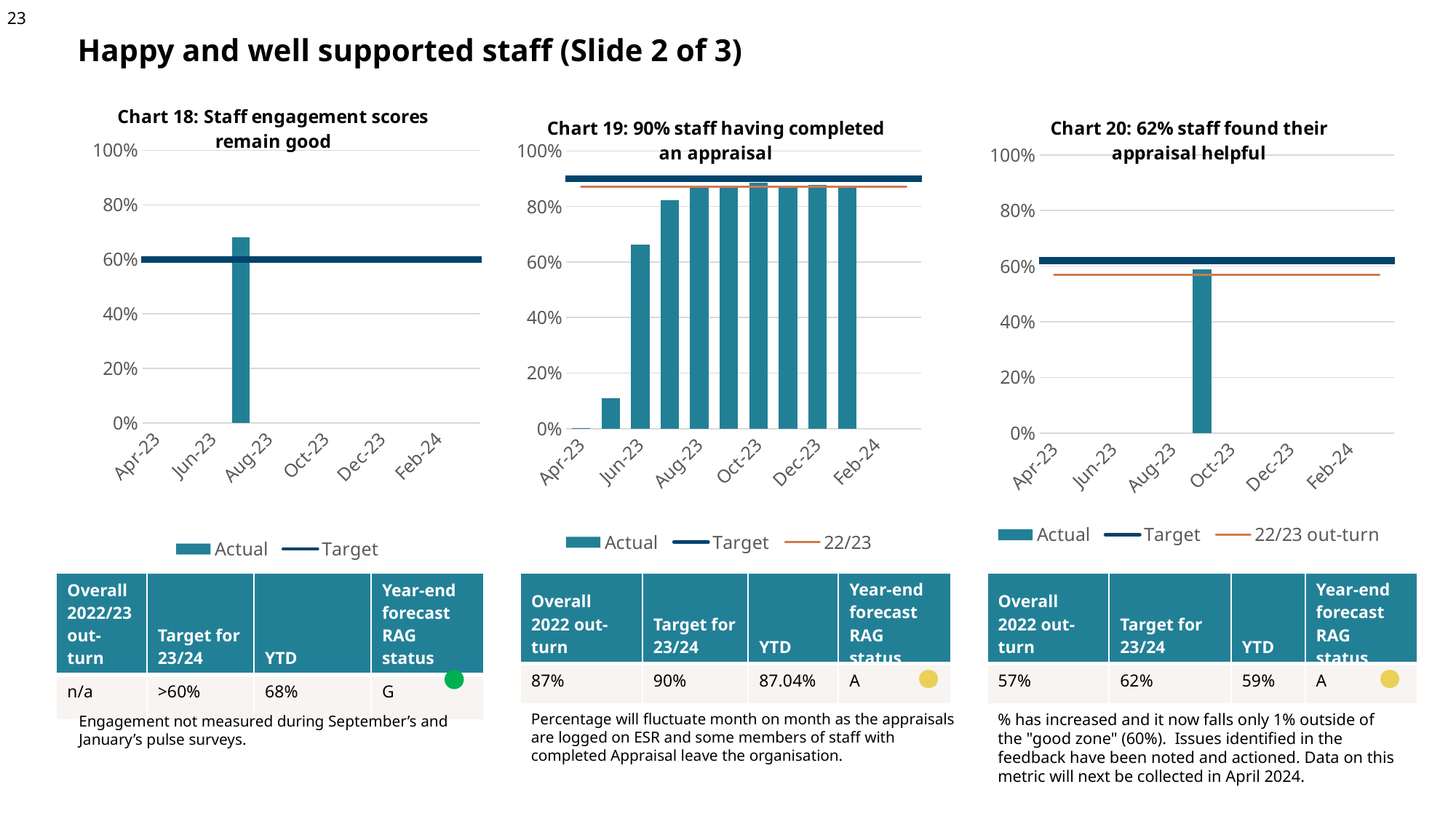
In Chart 19, is the Actual value for May-23 greater or less than 20%? less What kind of chart is Chart 18: Staff engagement scores remain good? bar and line chart How many bars are plotted in Chart 18? 1 What are the legend entries in Chart 20? Actual, Target, 22/23 out-turn In Chart 19, is the Actual value for Jun-23 greater or less than 80%? less In Chart 19, which is larger, the Actual value for Jun-23 or for Aug-23? Aug-23 How many series does the legend of Chart 20 list? 3 In Chart 19, do the Actual values rise or fall from Apr-23 to Aug-23? rise How many series does the legend of Chart 19 list? 3 How many series does the legend of Chart 18 list? 2